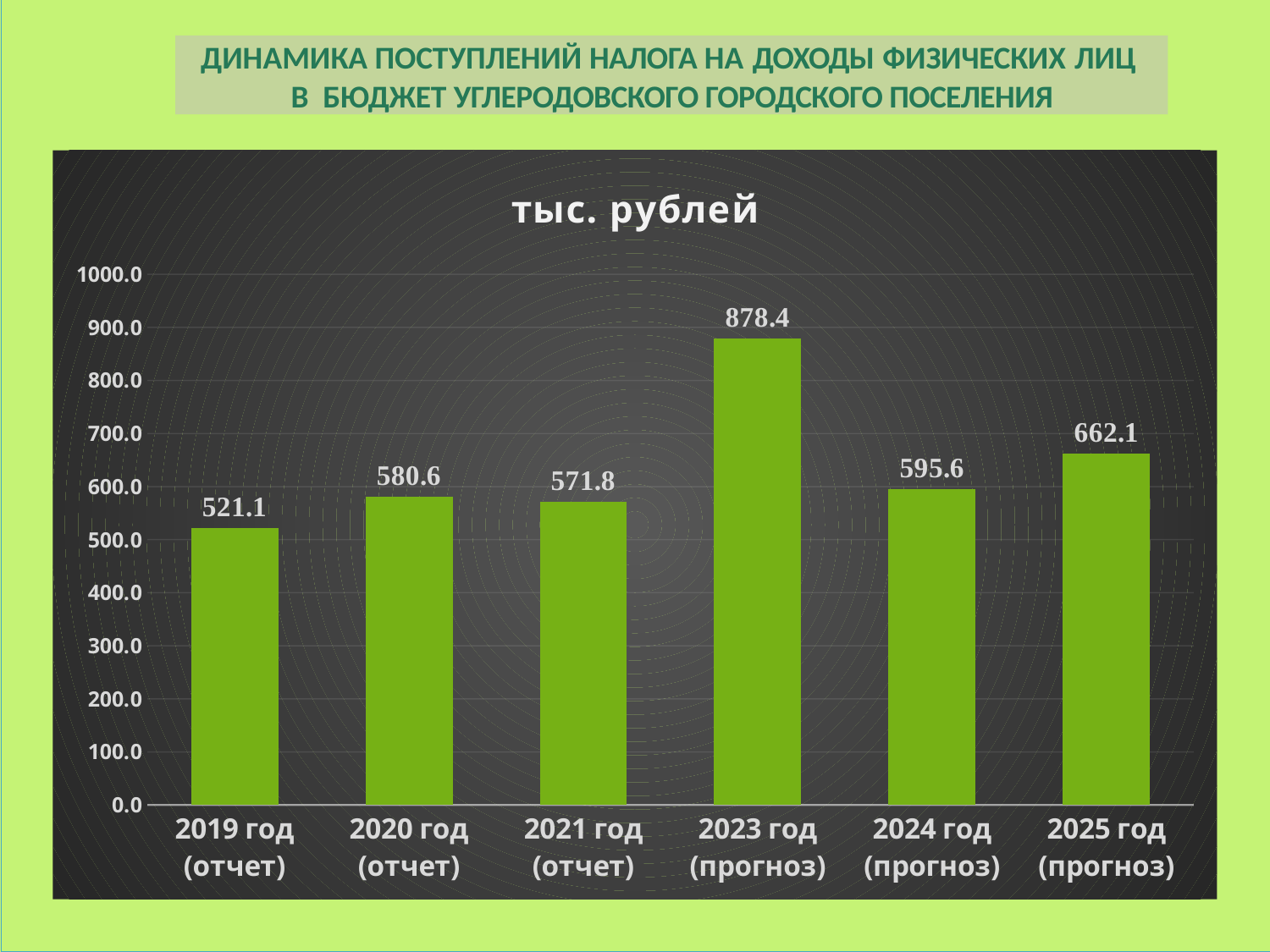
Which category has the lowest value? 2019 год (отчет) Which category has the highest value? 2023 год (прогноз) What is the title shown above the chart's plot area? тыс. рублей What is the value for 2025 год (прогноз)? 662.1 How many categories are shown on the x axis? 6 What is the value for 2019 год (отчет)? 521.1 What is the difference between the values for 2020 год (отчет) and 2019 год (отчет)? 59.5 Which is larger, the value for 2021 год (отчет) or the value for 2024 год (прогноз)? 2024 год (прогноз) What kind of chart is shown on the slide? bar chart What is the value for 2023 год (прогноз)? 878.4 Is the value for 2025 год (прогноз) greater or less than 600.0? greater What is the difference between the values for 2023 год (прогноз) and 2024 год (прогноз)? 282.8